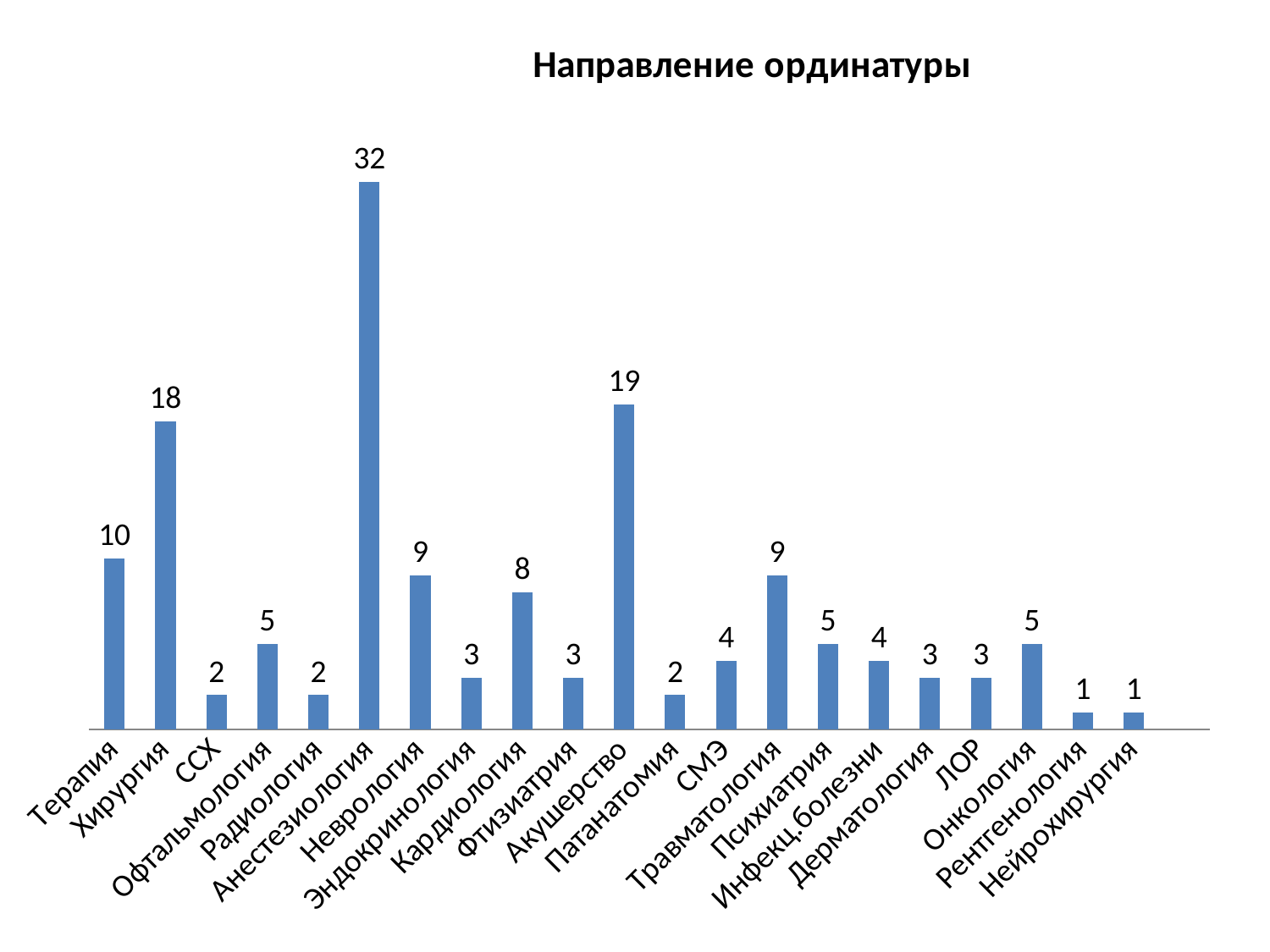
Which is larger, the value for Неврология or the value for Кардиология? Неврология What is the difference between the values for Хирургия and Терапия? 8 What is the difference between the values for Анестезиология and Акушерство? 13 What is the value for Акушерство? 19 How many categories are shown on the x axis? 21 What is the value for Анестезиология? 32 Which is larger, the value for Онкология or the value for Дерматология? Онкология What is the title of the chart? Направление ординатуры What kind of chart is shown on the slide? Bar chart Which category has the highest value? Анестезиология What is the value for Кардиология? 8 What is the value for Хирургия? 18